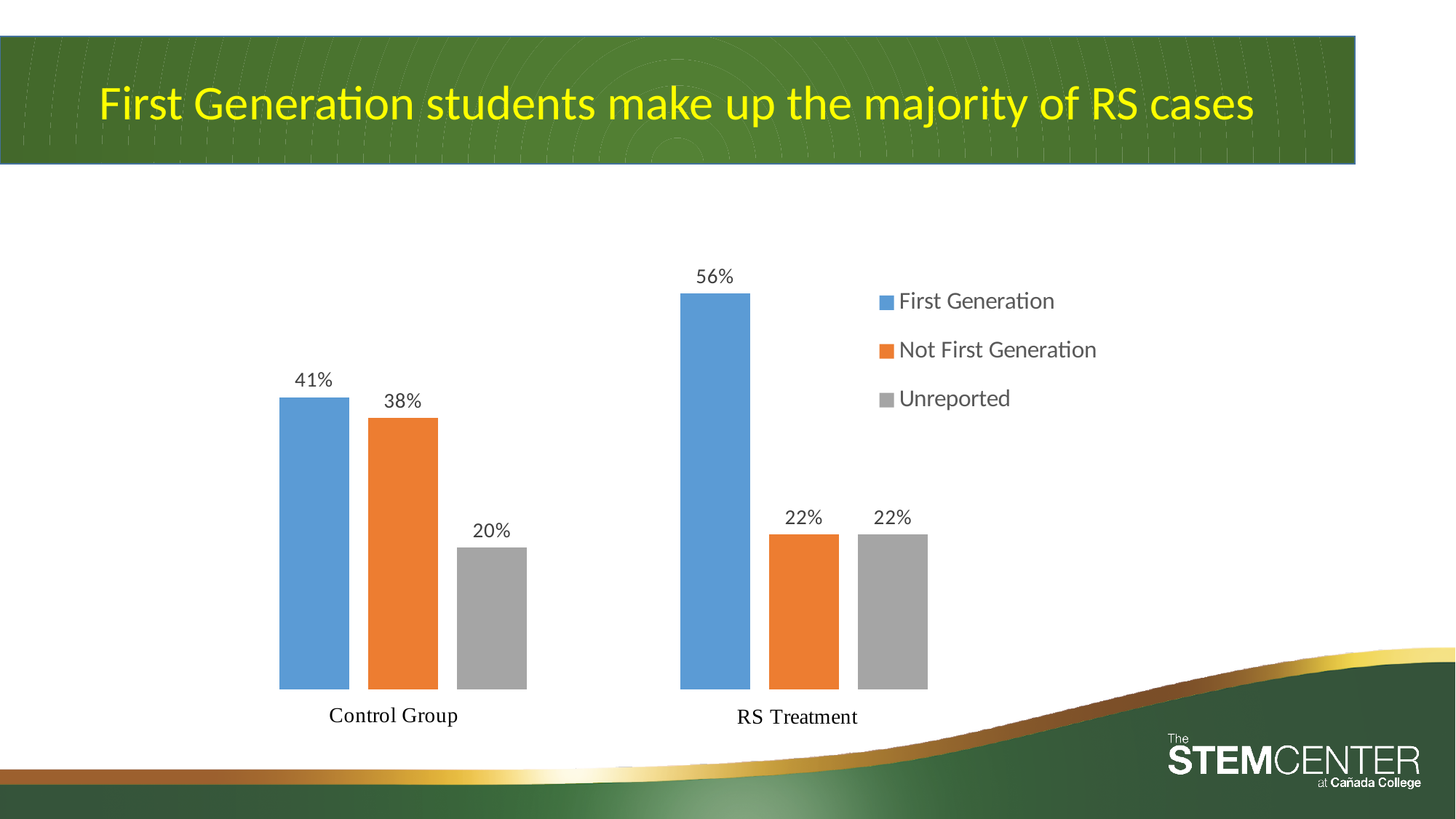
What is the difference between First Generation and Not First Generation in the Control Group? 3% What is the value for First Generation in the Control Group? 41% Which is larger: Not First Generation in the Control Group or Not First Generation in RS Treatment? Control Group What is the value for First Generation in the RS Treatment group? 56% What is the difference between the First Generation values for RS Treatment and Control Group? 15% How many categories are shown on the x axis? 2 What is the value for Unreported in the Control Group? 20% Which series has the highest value in the RS Treatment group? First Generation What is the value for Not First Generation in the RS Treatment group? 22% How many series does the legend list? 3 What kind of chart is shown on the slide? Bar chart Which series has the lowest value in the Control Group? Unreported